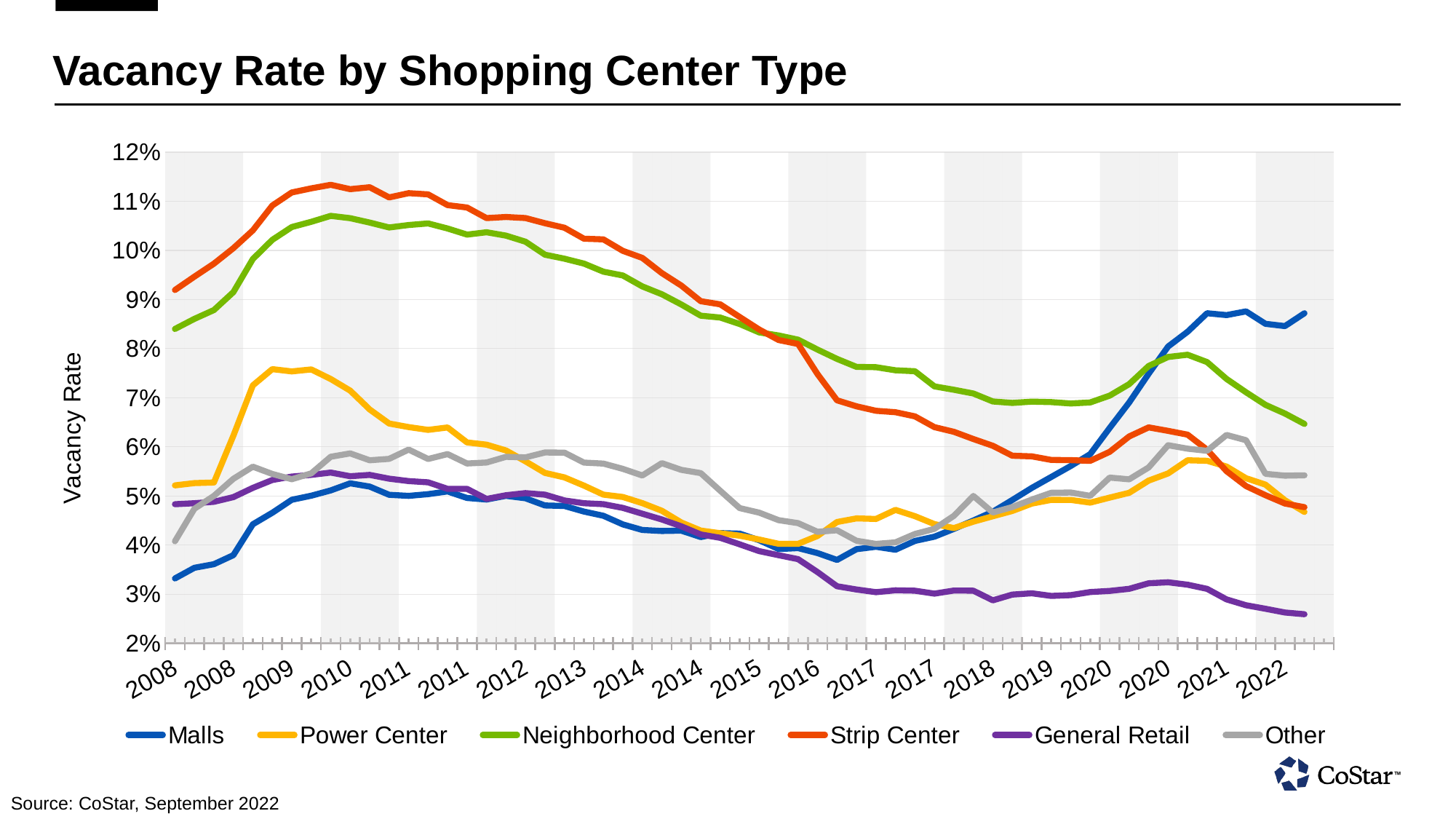
At the end of 2022, which series has the higher vacancy rate, Malls or Neighborhood Center? Malls What kind of chart is shown on the slide? Line chart What is the title of the chart? Vacancy Rate by Shopping Center Type Which series has the highest vacancy rate at the start of 2008? Strip Center Is the vacancy rate for Malls at the start of 2008 greater or less than 4%? less In 2009, which series has the higher vacancy rate, Power Center or Other? Power Center Does the Strip Center vacancy rate rise or fall from 2010 to 2019? Fall Is the vacancy rate for General Retail at the end of 2022 greater or less than 3%? less What source is cited below the chart? CoStar, September 2022 How many series does the legend list? 6 Is the vacancy rate for Strip Center at its 2010 peak greater or less than 11%? greater Which series has the lowest vacancy rate at the end of 2022? General Retail